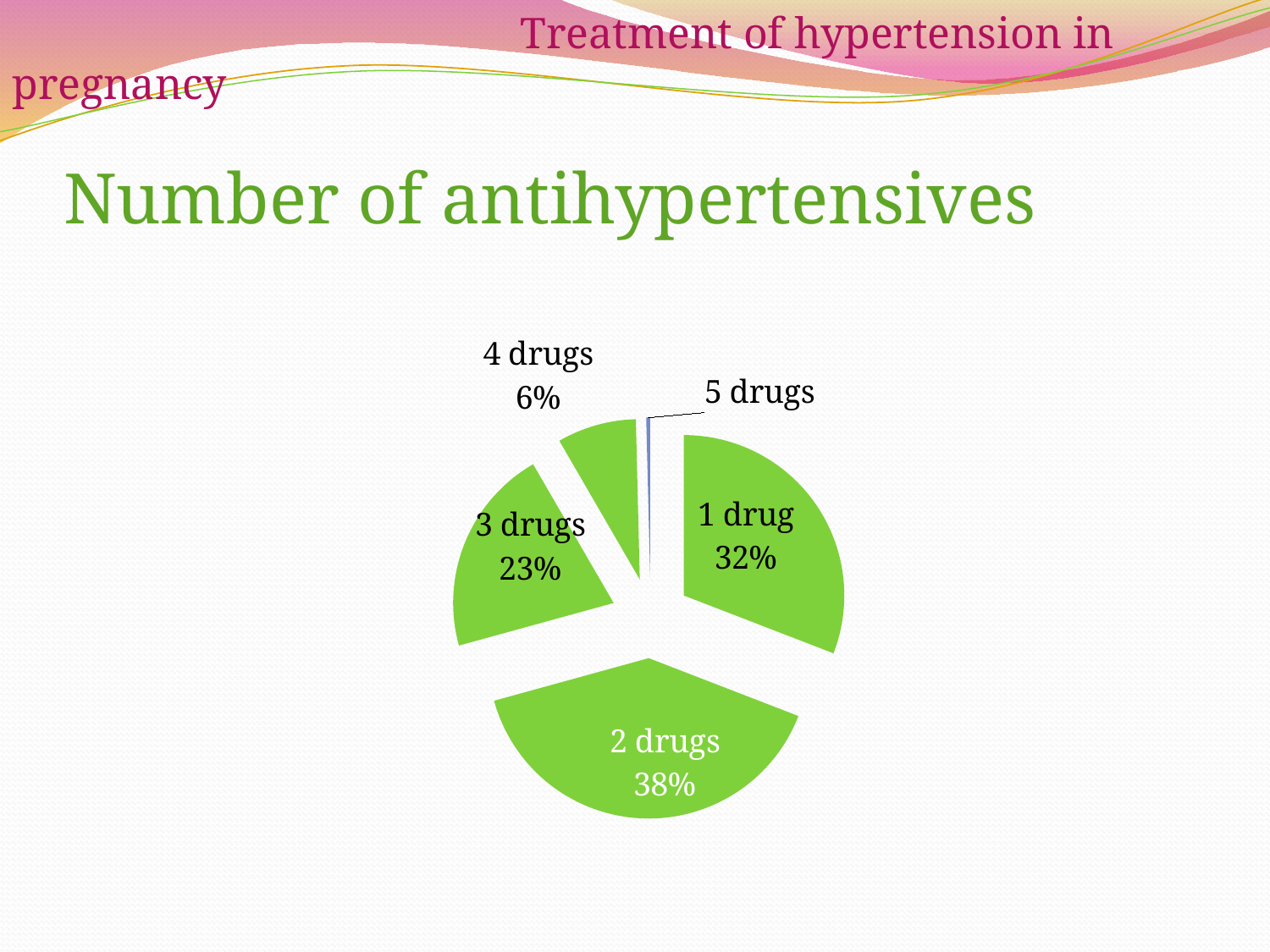
What is the difference in percentage points between the "3 drugs" and "4 drugs" slices? 17 What percentage is shown for the "3 drugs" slice? 23% What is the difference in percentage points between the "2 drugs" and "1 drug" slices? 6 What percentage is shown for the "4 drugs" slice? 6% How many categories (slices) does the pie chart have? 5 Which category has the smallest slice of the pie? 5 drugs What percentage is shown for the "1 drug" slice? 32% What is the title of the chart on the slide? Number of antihypertensives What share of the pie does the "2 drugs" slice represent? 38% Which slice is larger, "1 drug" or "3 drugs"? 1 drug Which category has the largest slice of the pie? 2 drugs What kind of chart is shown on the slide? Pie chart